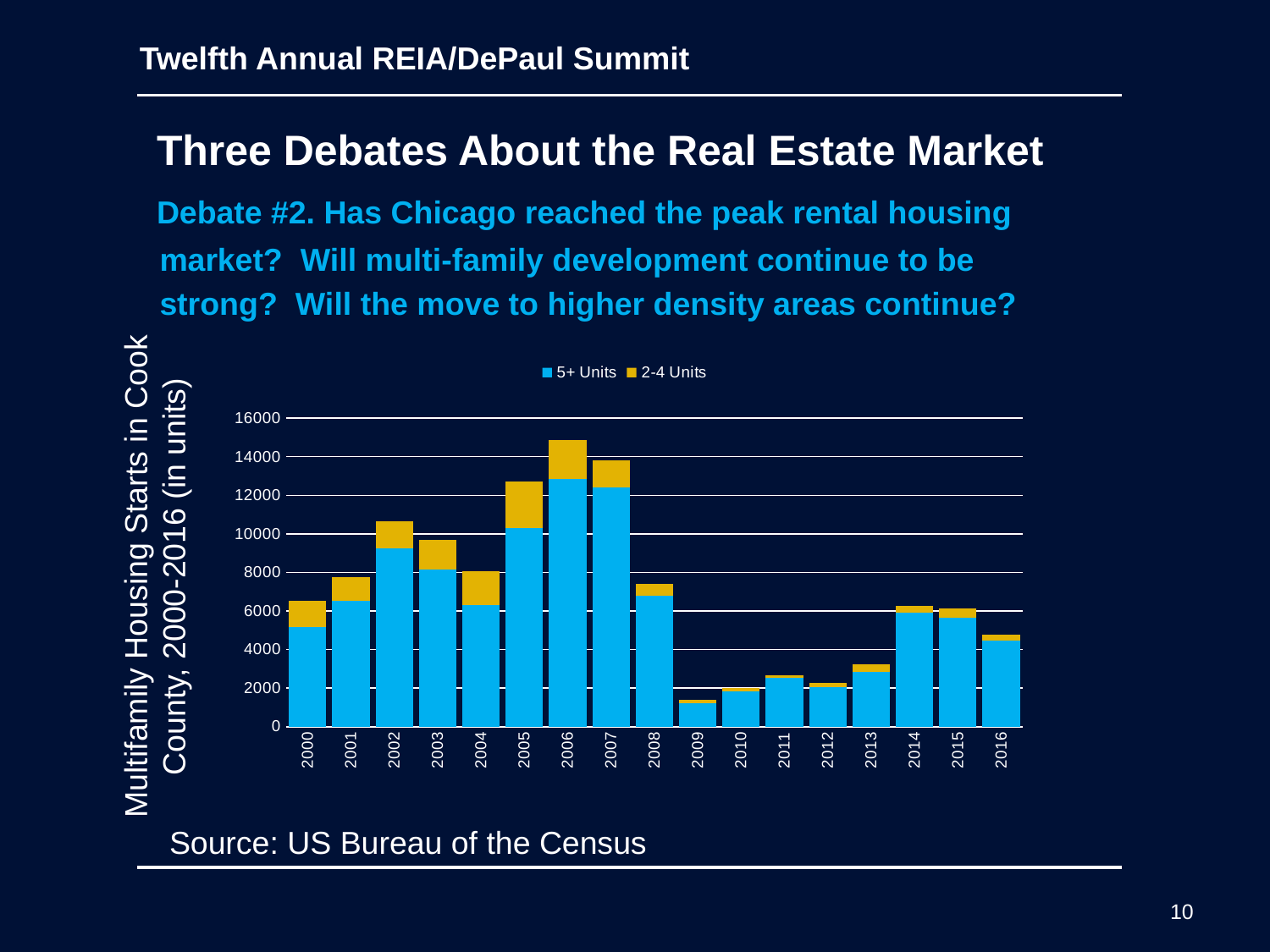
Do the total values rise or fall from 2006 to 2009? fall Is the total value for 2016 greater or less than 6000? less Which year has the lowest total multifamily housing starts? 2009 Which year has the highest total multifamily housing starts? 2006 Is the total value for 2009 greater or less than 2000? less Is the total value for 2002 greater or less than 10000? greater How many years (categories) are plotted along the x axis? 17 What kind of chart is shown on the slide? Stacked bar chart Which year has a larger total, 2005 or 2008? 2005 Which two series are listed in the legend? 5+ Units and 2-4 Units How many series does the legend list? 2